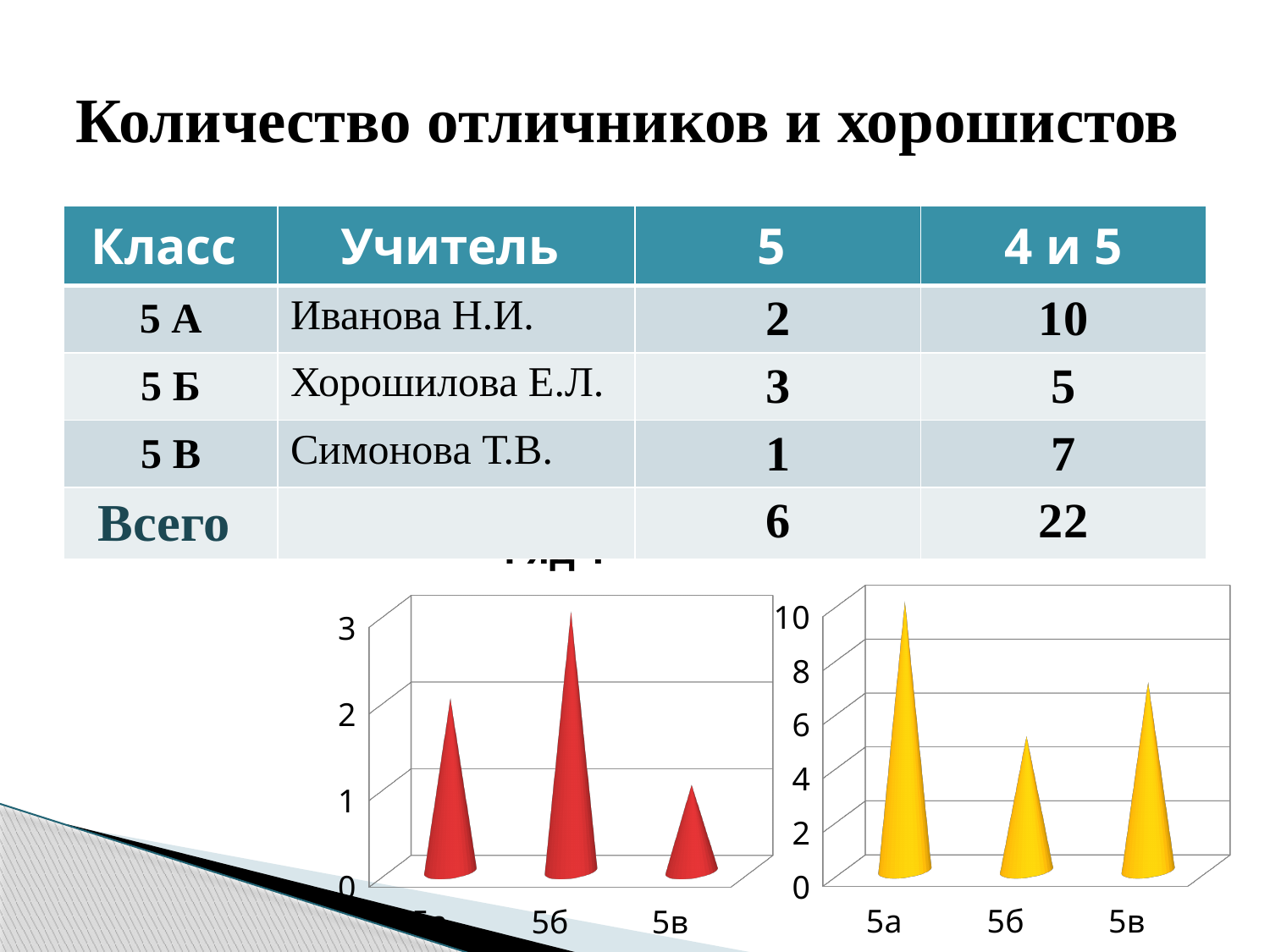
In the right chart with yellow cones, which class has the highest value? 5а In the left chart with red cones, what is the difference between the values for 5б and 5в? 2 In the right chart with yellow cones, what is the value for 5а? 10 In the right chart with yellow cones, which class has the lowest value? 5б What kind of chart is the left chart with red cones? bar chart In the right chart with yellow cones, is the value for 5б greater or less than 6? less In the left chart with red cones, what is the value for 5б? 3 In the right chart with yellow cones, which is larger, the value for 5в or the value for 5б? 5в In the left chart with red cones, which class has the highest value? 5б In the right chart with yellow cones, is the value for 5в greater or less than 6? greater In the left chart with red cones, how many classes are shown on the x axis? 3 In the left chart with red cones, which class has the lowest value? 5в